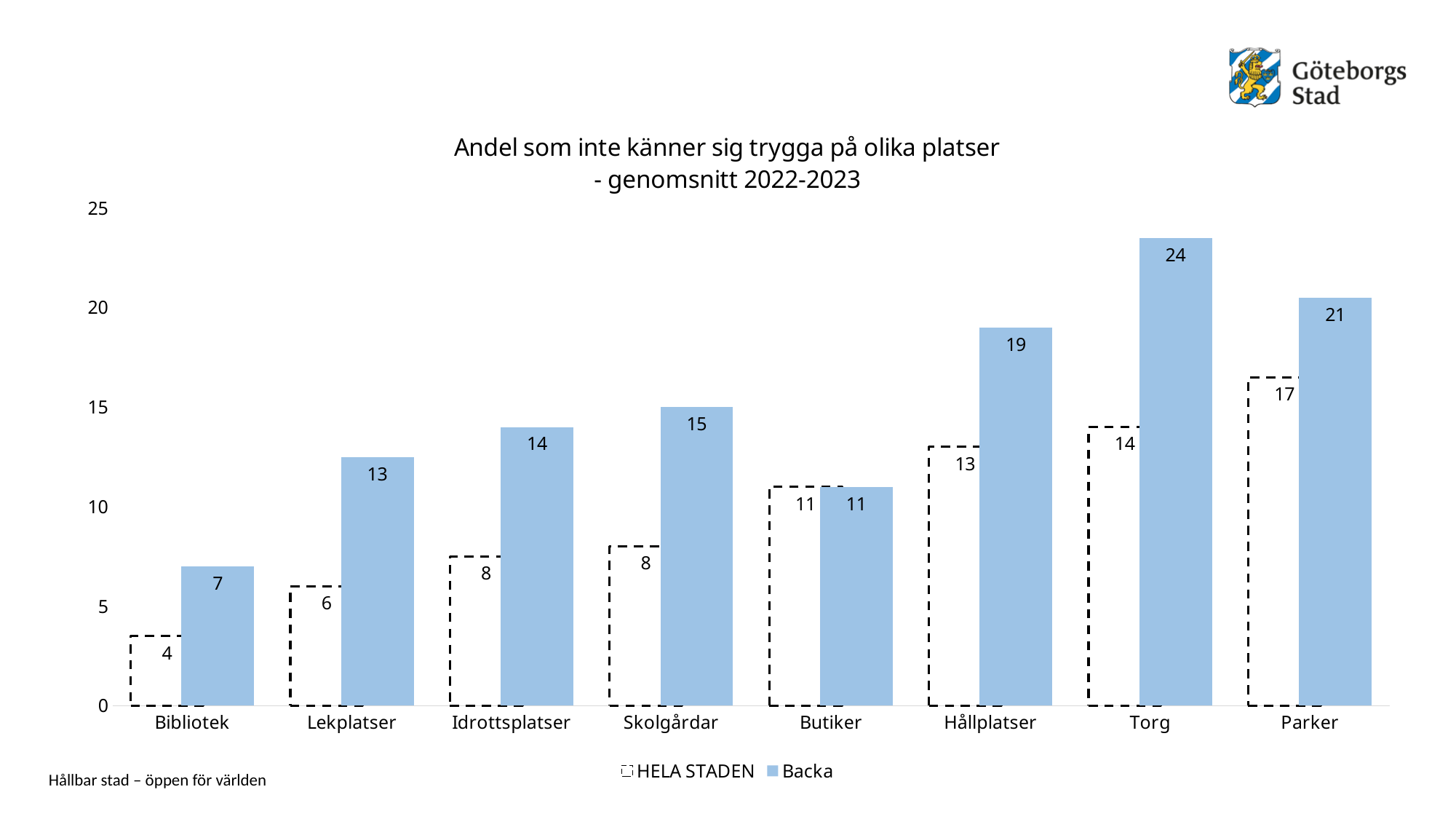
What is the value for Backa at Hållplatser? 19 Which category has the lowest value for HELA STADEN? Bibliotek How many series does the legend list? 2 What kind of chart is shown on the slide? Bar chart What is the value for HELA STADEN at Bibliotek? 4 Is the value for Backa at Parker greater or less than 20? greater What is the title of the chart? Andel som inte känner sig trygga på olika platser - genomsnitt 2022-2023 What is the value for Backa at Torg? 24 Which category has the highest value for Backa? Torg How many categories are shown on the x axis? 8 Which is larger at Lekplatser: the Backa value or the HELA STADEN value? Backa What is the difference between the Backa and HELA STADEN values at Torg? 10